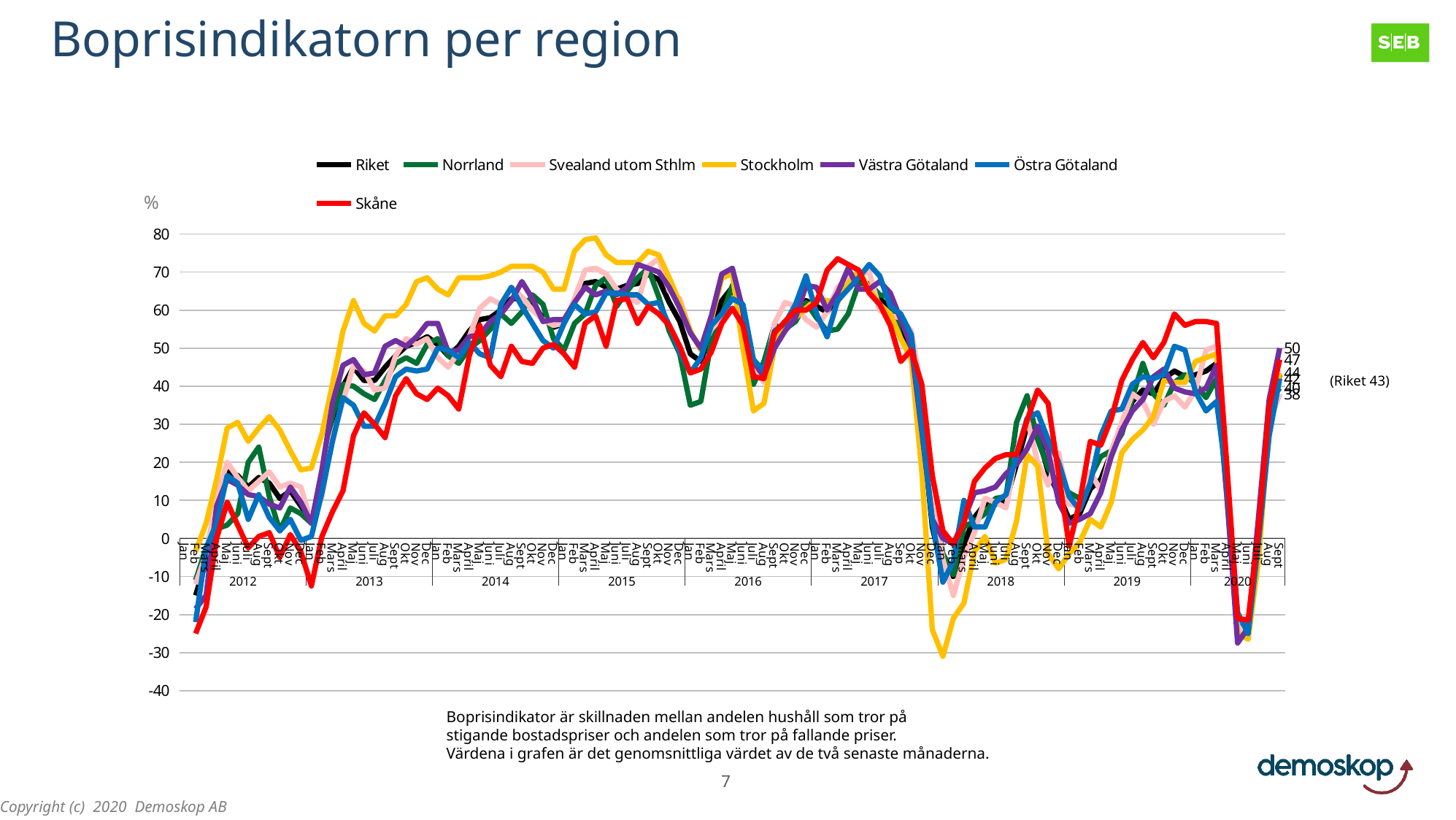
What kind of chart is shown on the slide? line chart Which series drops to the lowest value on the chart, around the start of 2018? Stockholm Do the values generally rise or fall from 2012 to 2015? rise Is the lowest value for Stockholm around the start of 2018 greater or less than -20? less Which series reaches the highest value on the chart, around 2015? Stockholm What is the latest value for Riket, as noted on the chart? 43 How many series does the legend list? 7 What is the title of the chart? Boprisindikatorn per region Is the peak value for Stockholm in 2015 greater or less than 70? greater How many years are labelled along the x axis? 9 What colour is the Skåne line in the legend? red What is the lowest value shown on the y axis? -40